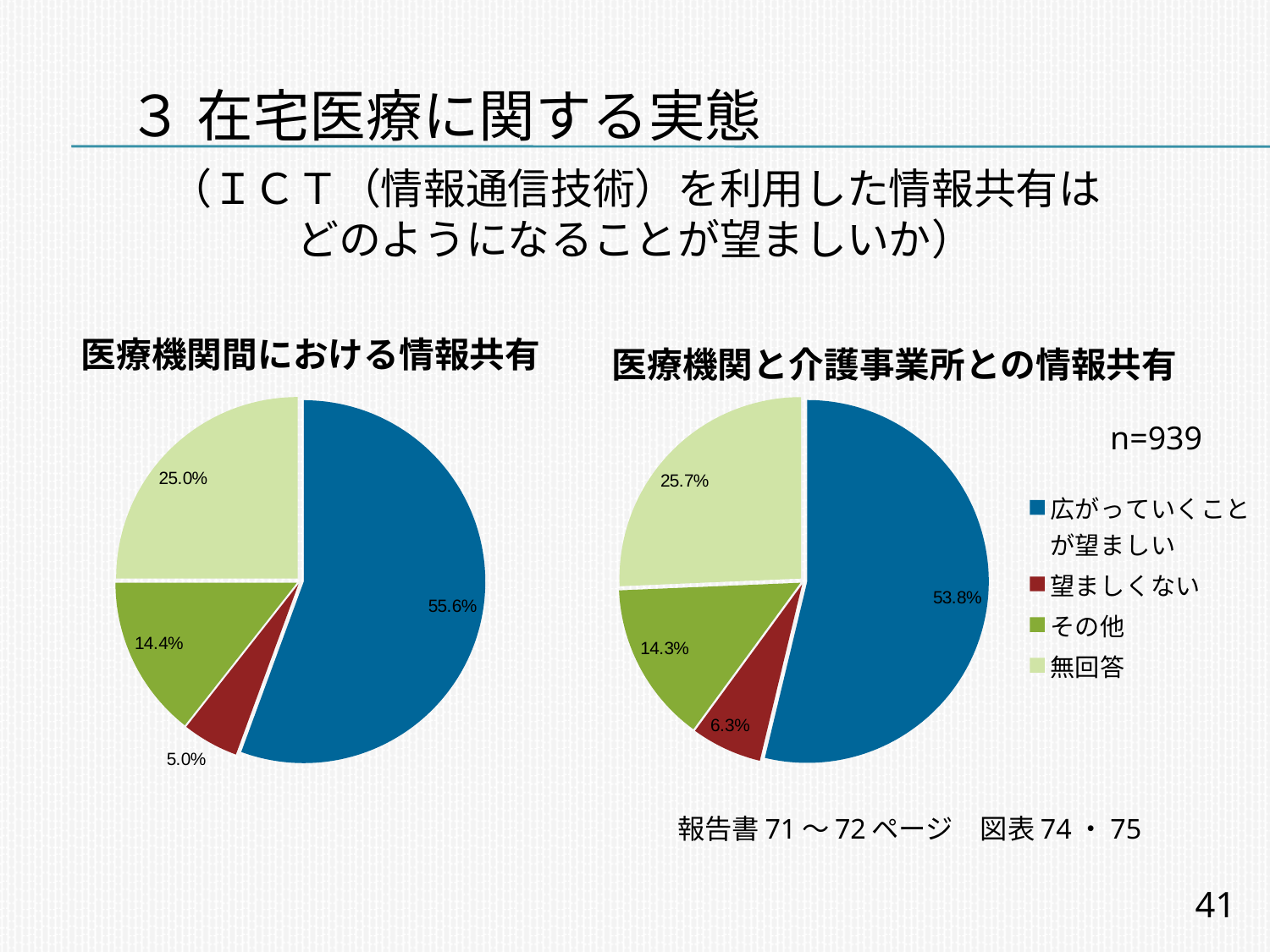
In the right pie chart (医療機関と介護事業所との情報共有), which category has the largest share? 広がっていくことが望ましい Which is larger: the share for 望ましくない in the left pie chart or in the right pie chart? Right pie chart (6.3%) How many slices does the right pie chart (医療機関と介護事業所との情報共有) have? 4 In the left pie chart (医療機関間における情報共有), which category has the smallest share? 望ましくない In the right pie chart (医療機関と介護事業所との情報共有), what is the share for 無回答? 25.7% In the right pie chart (医療機関と介護事業所との情報共有), what is the share for その他? 14.3% How many entries does the legend list? 4 What sample size (n) is shown on the slide? n=939 What kind of chart is used on this slide? Pie chart In the left pie chart (医療機関間における情報共有), what is the difference between the shares for 無回答 and その他? 10.6% In the left pie chart (医療機関間における情報共有), what is the share for 望ましくない? 5.0% In the left pie chart (医療機関間における情報共有), what is the share for 広がっていくことが望ましい? 55.6%